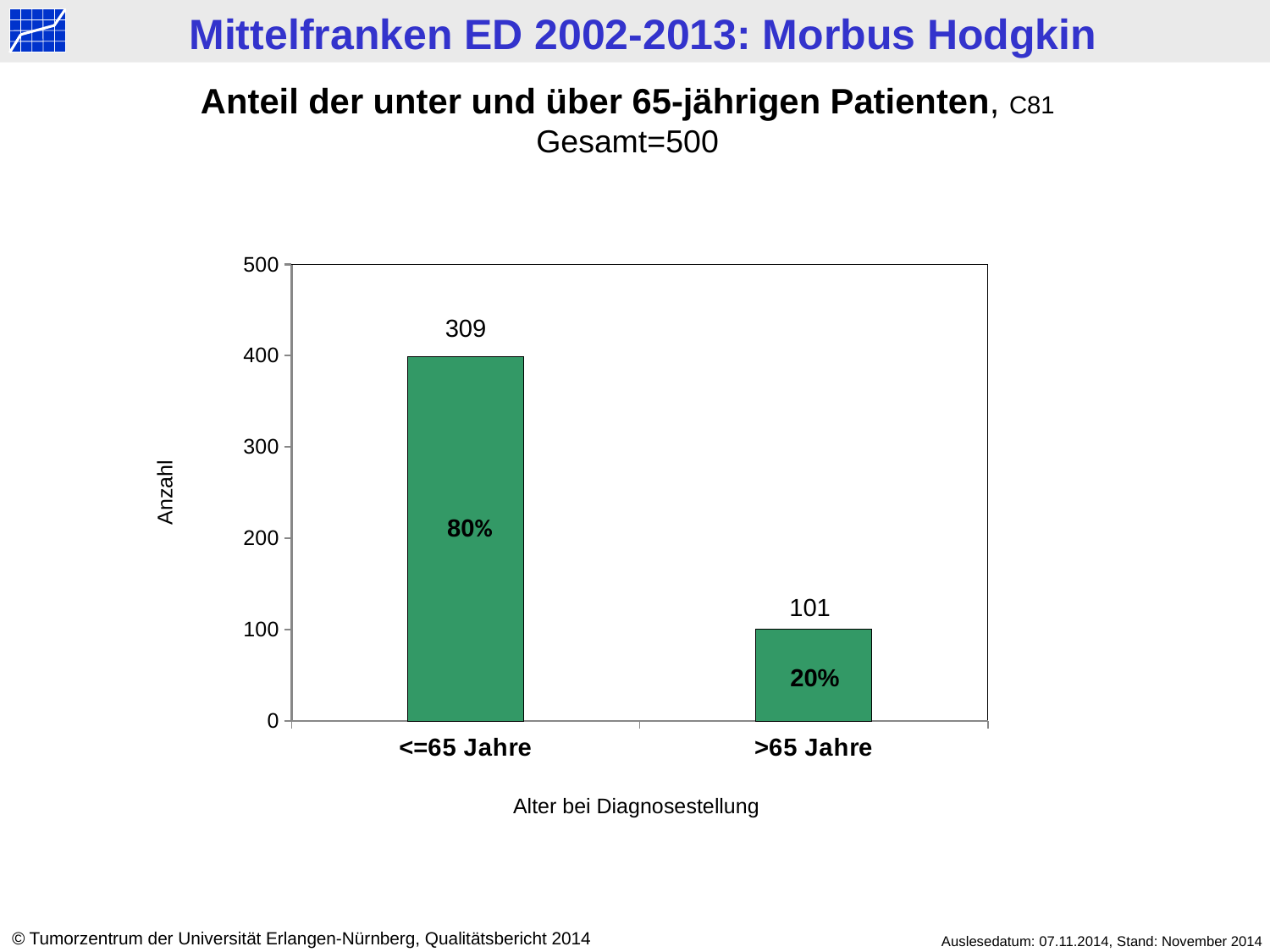
Which is larger, the value for <=65 Jahre or for >65 Jahre? <=65 Jahre What percentage is shown on the bar for <=65 Jahre? 80% What kind of chart is shown on the slide? bar chart Is the value for >65 Jahre greater or less than 200? less What is the value for >65 Jahre? 101 What is the difference between the values for <=65 Jahre and >65 Jahre? 208 What percentage is shown on the bar for >65 Jahre? 20% What is the label of the y axis? Anzahl Which age group has the lowest value? >65 Jahre What is the value for <=65 Jahre? 309 Which age group has the highest value? <=65 Jahre How many age categories are shown on the x axis? 2